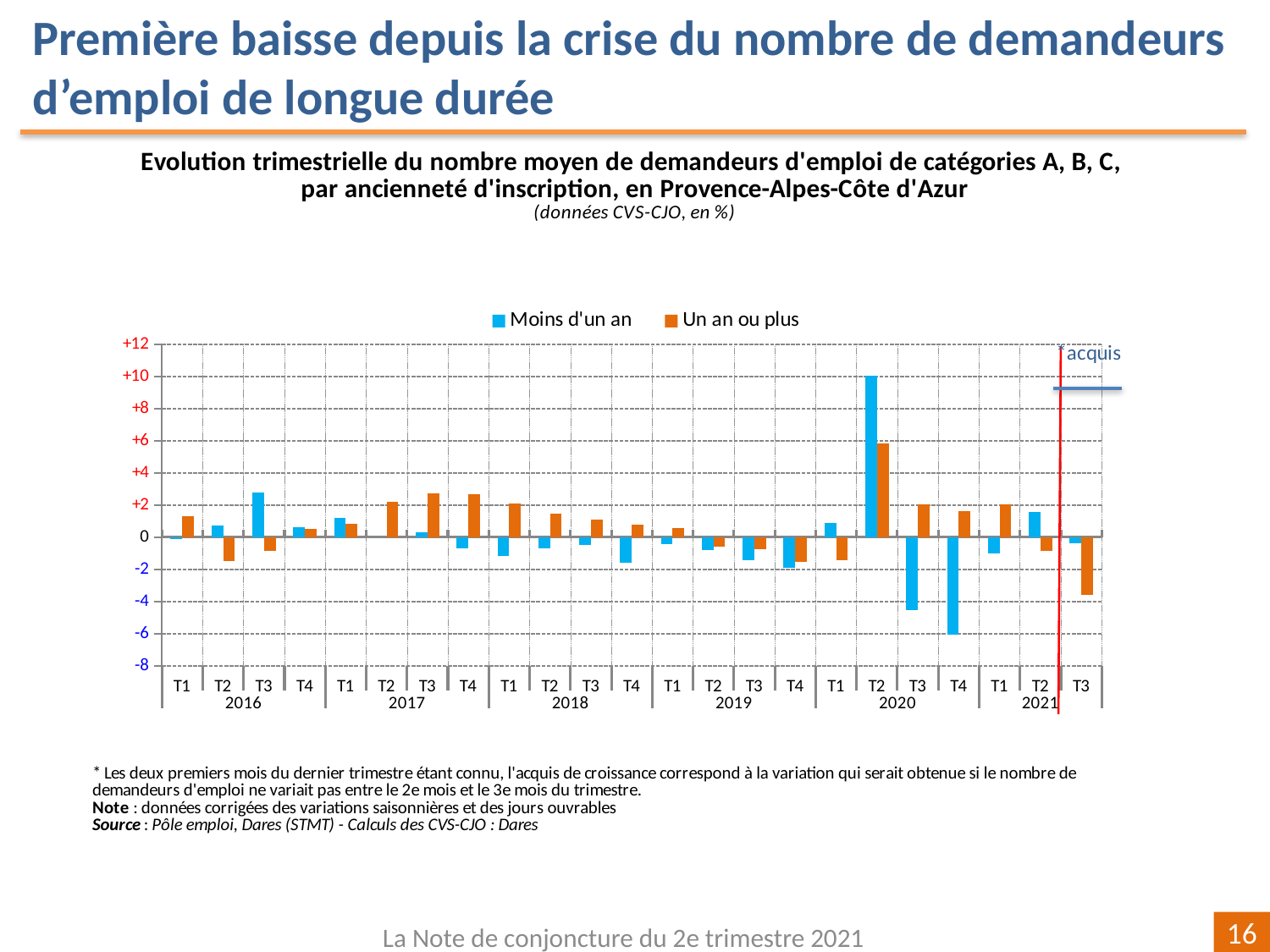
Is the value for 'Un an ou plus' in T3 2021 greater or less than -2? less How many series does the legend list? 2 In which quarter is the value for 'Un an ou plus' highest? T2 2020 What are the two series named in the legend? Moins d'un an; Un an ou plus In T2 2020, which series has the larger value, 'Moins d'un an' or 'Un an ou plus'? Moins d'un an In which quarter is the value for 'Un an ou plus' lowest? T3 2021 What kind of chart is shown on the slide? bar chart How many quarters are plotted on the x axis, from T1 2016 to T3 2021? 23 In T3 2020, which series has the larger value, 'Moins d'un an' or 'Un an ou plus'? Un an ou plus In which quarter is the value for 'Moins d'un an' lowest? T4 2020 Is the value for 'Moins d'un an' in T2 2020 greater or less than +8? greater In which quarter is the value for 'Moins d'un an' highest? T2 2020